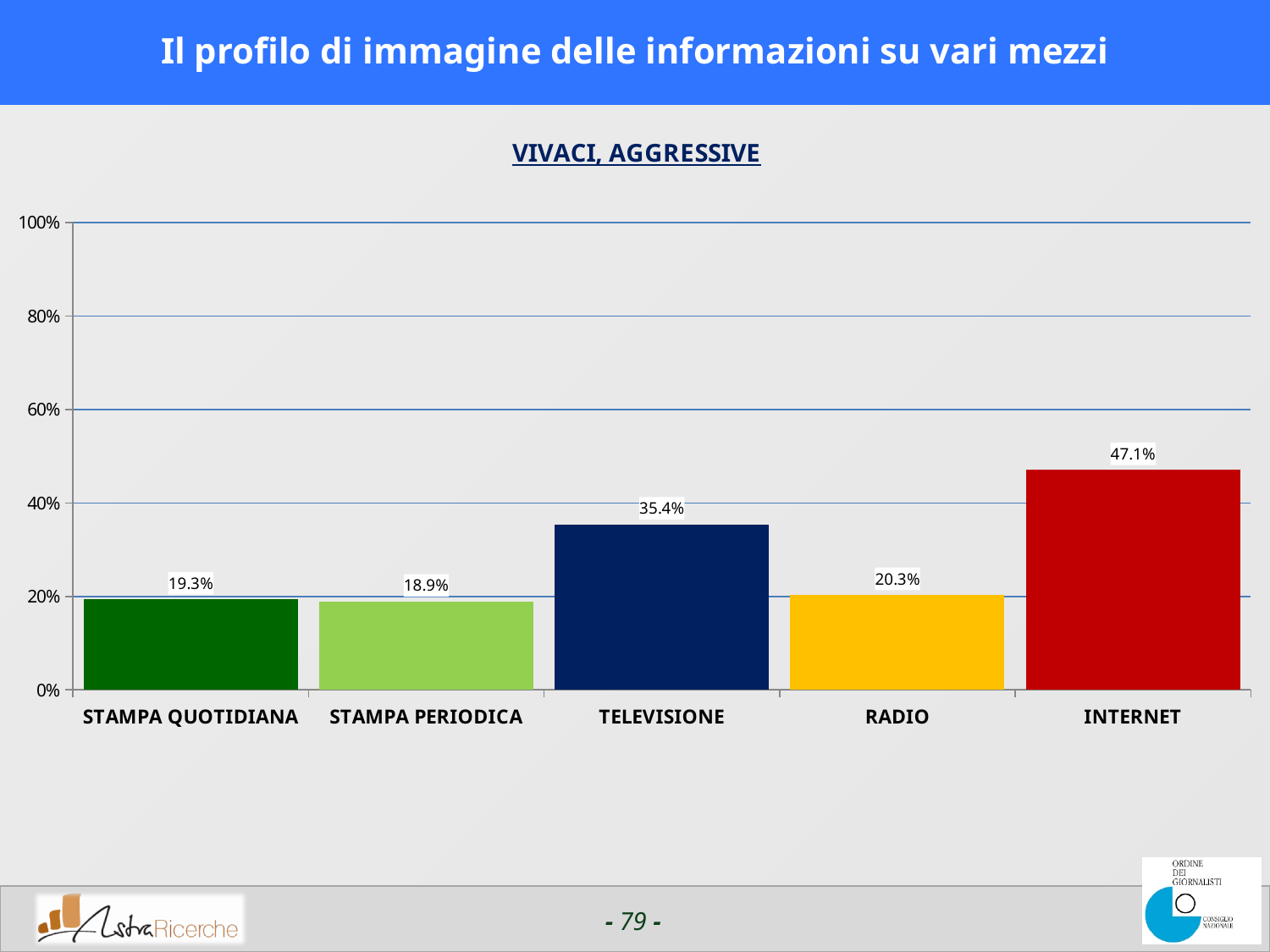
Which category has the highest value? INTERNET What is the value for RADIO? 20.3% What is the difference between the values for INTERNET and TELEVISIONE? 11.7% Which is larger, the value for RADIO or the value for TELEVISIONE? TELEVISIONE What is the value for STAMPA PERIODICA? 18.9% Is the value for INTERNET greater or less than 40%? greater What is the title shown above the chart? VIVACI, AGGRESSIVE What is the difference between the values for STAMPA QUOTIDIANA and STAMPA PERIODICA? 0.4% Which category has the lowest value? STAMPA PERIODICA What is the value for TELEVISIONE? 35.4% What kind of chart is shown on the slide? bar chart How many categories are shown on the x axis? 5